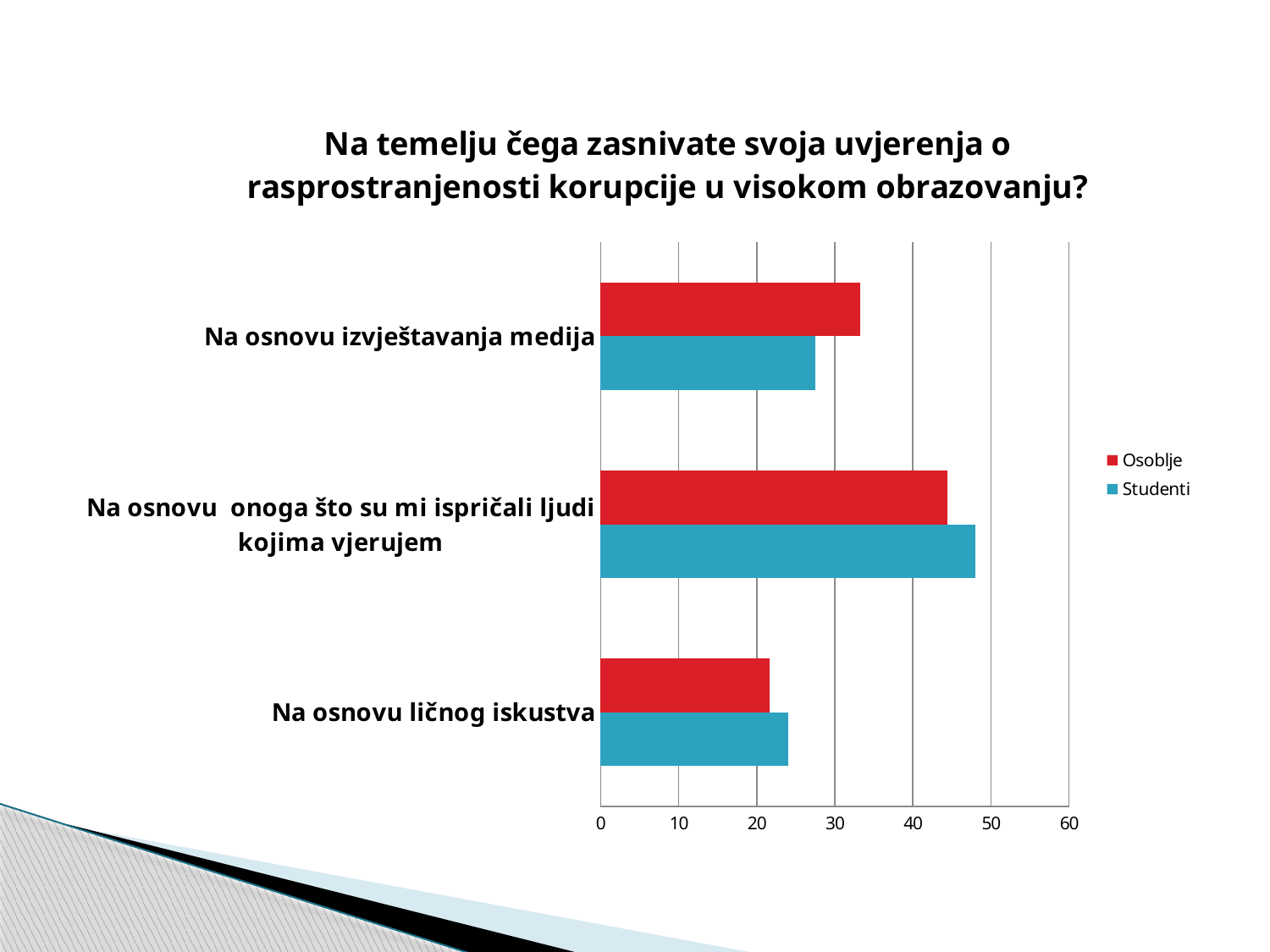
For 'Na osnovu izvještavanja medija', which series has the larger value, Osoblje or Studenti? Osoblje How many categories are shown on the chart? 3 For 'Na osnovu onoga što su mi ispričali ljudi kojima vjerujem', which series has the larger value, Osoblje or Studenti? Studenti Is the Osoblje value for 'Na osnovu ličnog iskustva' greater or less than 30? less How many series does the legend list? 2 Is the Osoblje value for 'Na osnovu izvještavanja medija' greater or less than 30? greater What kind of chart is shown on the slide? bar chart Which colour represents the Studenti series in the chart? blue Is the Studenti value for 'Na osnovu onoga što su mi ispričali ljudi kojima vjerujem' greater or less than 40? greater Which category has the lowest value for Studenti? Na osnovu ličnog iskustva Which category has the lowest value for Osoblje? Na osnovu ličnog iskustva Which category has the highest value for Osoblje? Na osnovu onoga što su mi ispričali ljudi kojima vjerujem